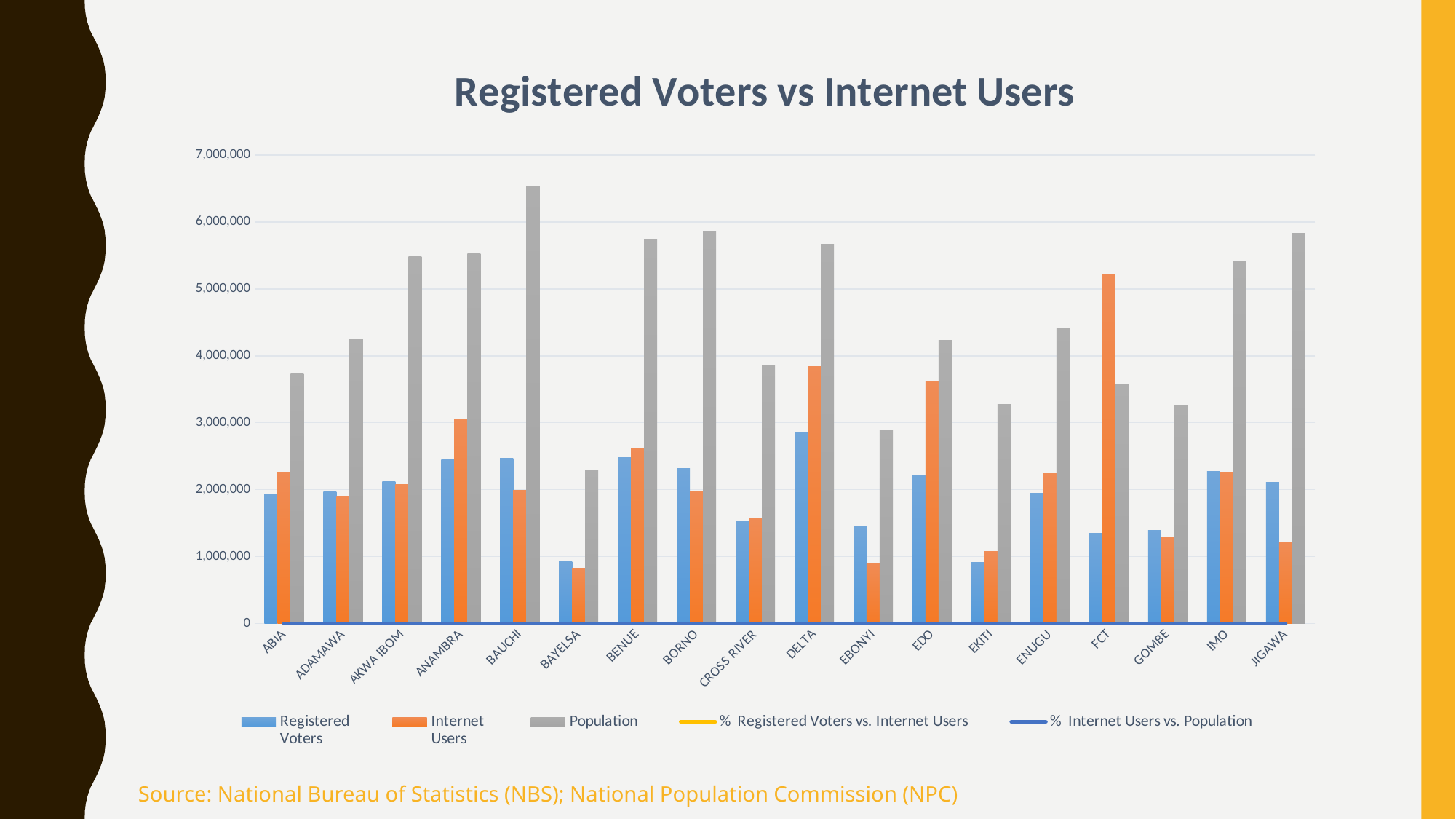
Which category has the highest Internet Users bar? FCT For FCT, which is larger: Internet Users or Population? Internet Users Which state has the highest Population bar? BAUCHI What kind of chart is shown on the slide? Bar chart Which state has the lowest Population bar? BAYELSA Is the Population value for BAYELSA greater or less than 3,000,000? less How many series does the legend list? 5 How many states/territories are shown along the x axis of the chart? 18 Which state has the highest Registered Voters bar? DELTA For BAUCHI, which is larger: Registered Voters or Internet Users? Registered Voters Is the Internet Users value for FCT greater or less than 5,000,000? greater